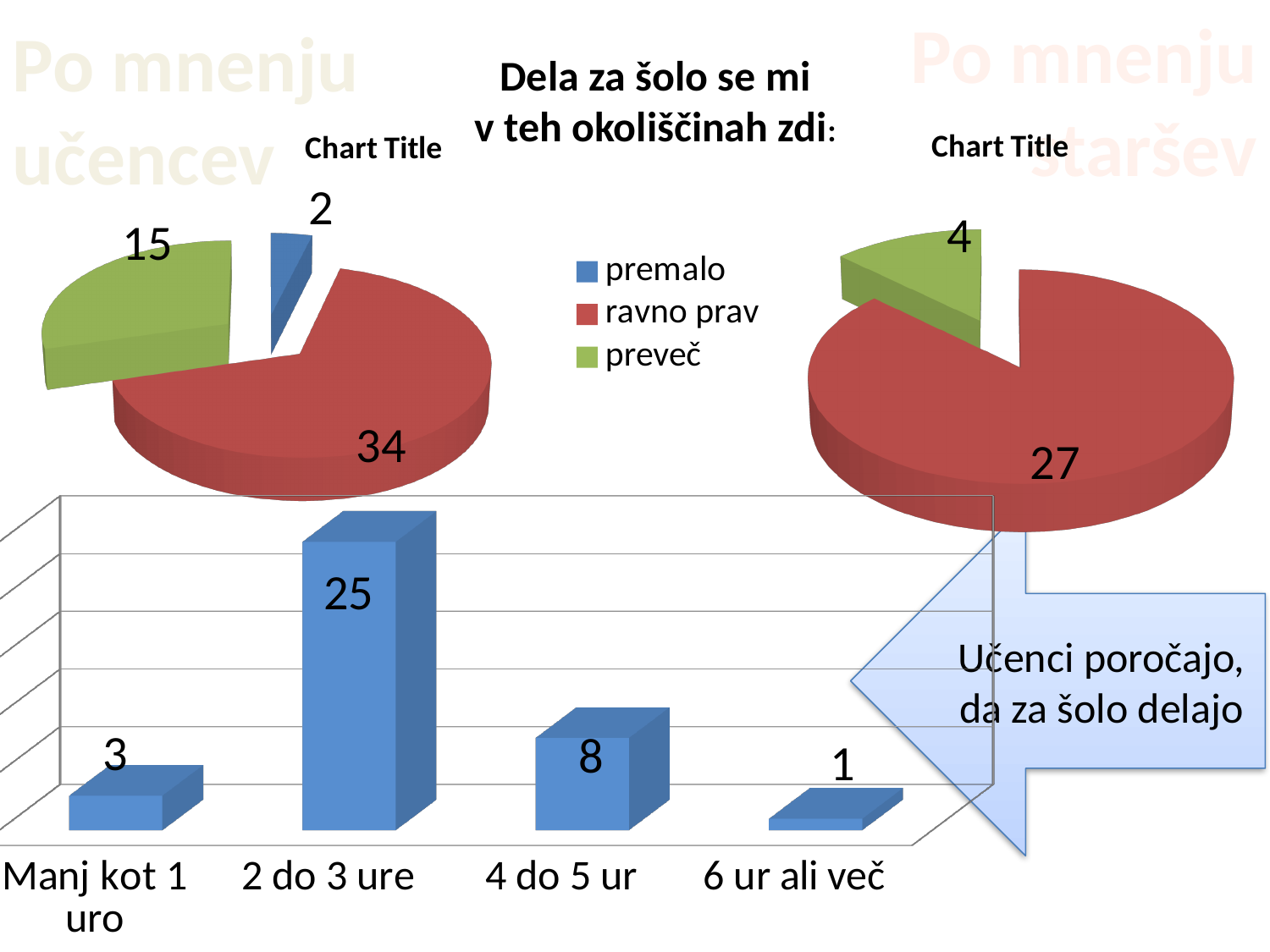
In the pie chart on the left of the slide, what is the value for 'premalo'? 2 In the bar chart at the bottom of the slide, how many categories are shown on the x axis? 4 In the bar chart at the bottom of the slide, which category has the highest value? 2 do 3 ure What kind of chart is the chart at the bottom of the slide? bar chart In the pie chart on the left of the slide, what is the value for 'ravno prav'? 34 In the pie chart on the left of the slide, which slice is the largest? ravno prav In the bar chart at the bottom of the slide, which category has the lowest value? 6 ur ali več In the bar chart at the bottom of the slide, what is the value for '2 do 3 ure'? 25 In the bar chart at the bottom of the slide, what is the difference between the values for '2 do 3 ure' and '4 do 5 ur'? 17 In the pie chart on the right of the slide, which is larger, 'ravno prav' or 'preveč'? ravno prav In the pie chart on the right of the slide, what is the value for 'preveč'? 4 How many entries does the legend between the two pie charts list? 3